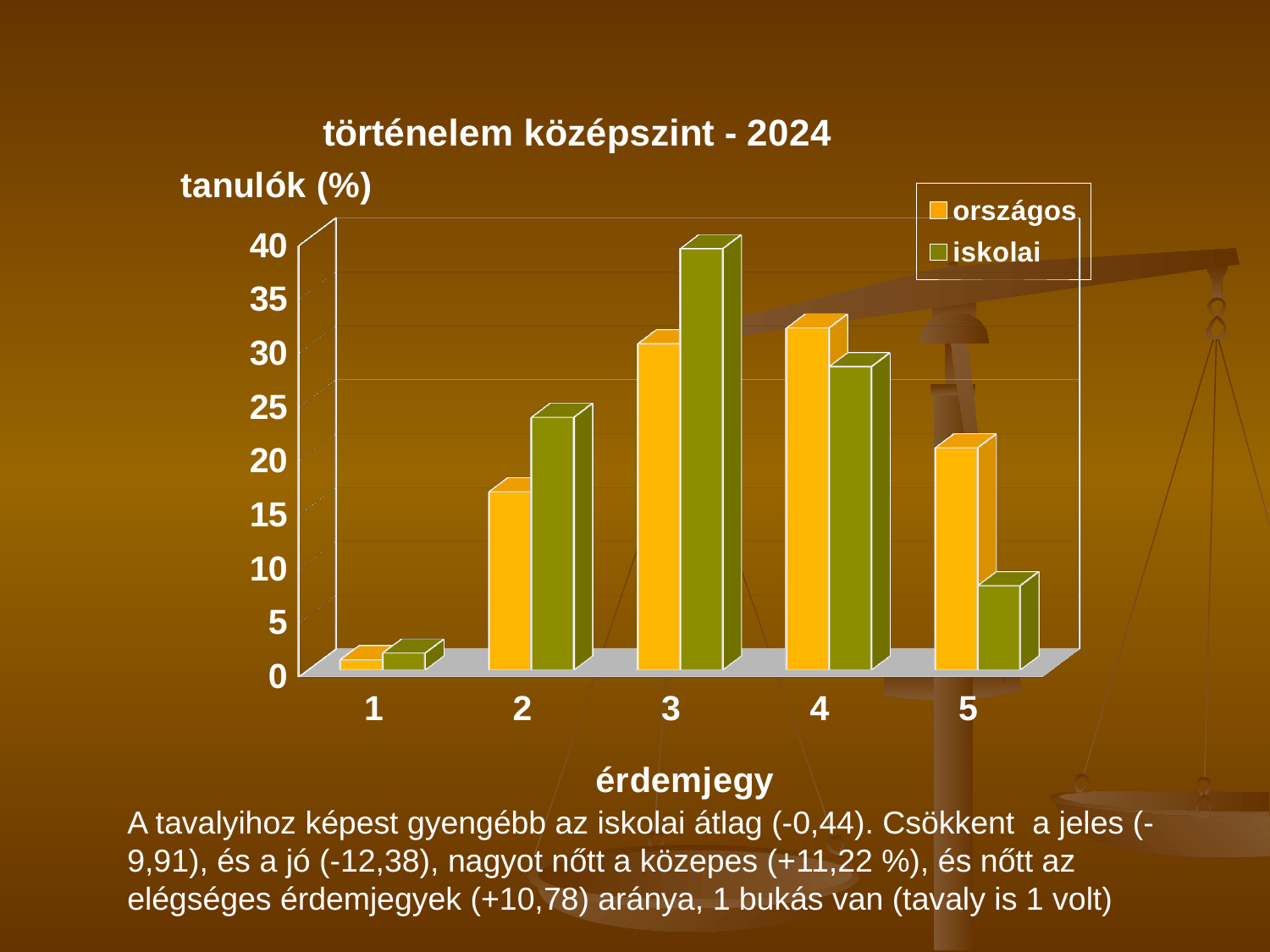
Is the iskolai value for grade 5 greater or less than 10? less For grade 2, which series has the larger value, országos or iskolai? iskolai For which grade is the iskolai value lowest? 1 How many grade categories (érdemjegy) are shown on the x axis? 5 For grade 5, which series has the larger value, országos or iskolai? országos For which grade is the országos value lowest? 1 What is the title of the chart? történelem középszint - 2024 Is the iskolai value for grade 3 greater or less than 35? greater For which grade is the iskolai value highest? 3 What kind of chart is shown on the slide? bar chart Is the országos value for grade 2 greater or less than 20? less How many series does the legend list? 2